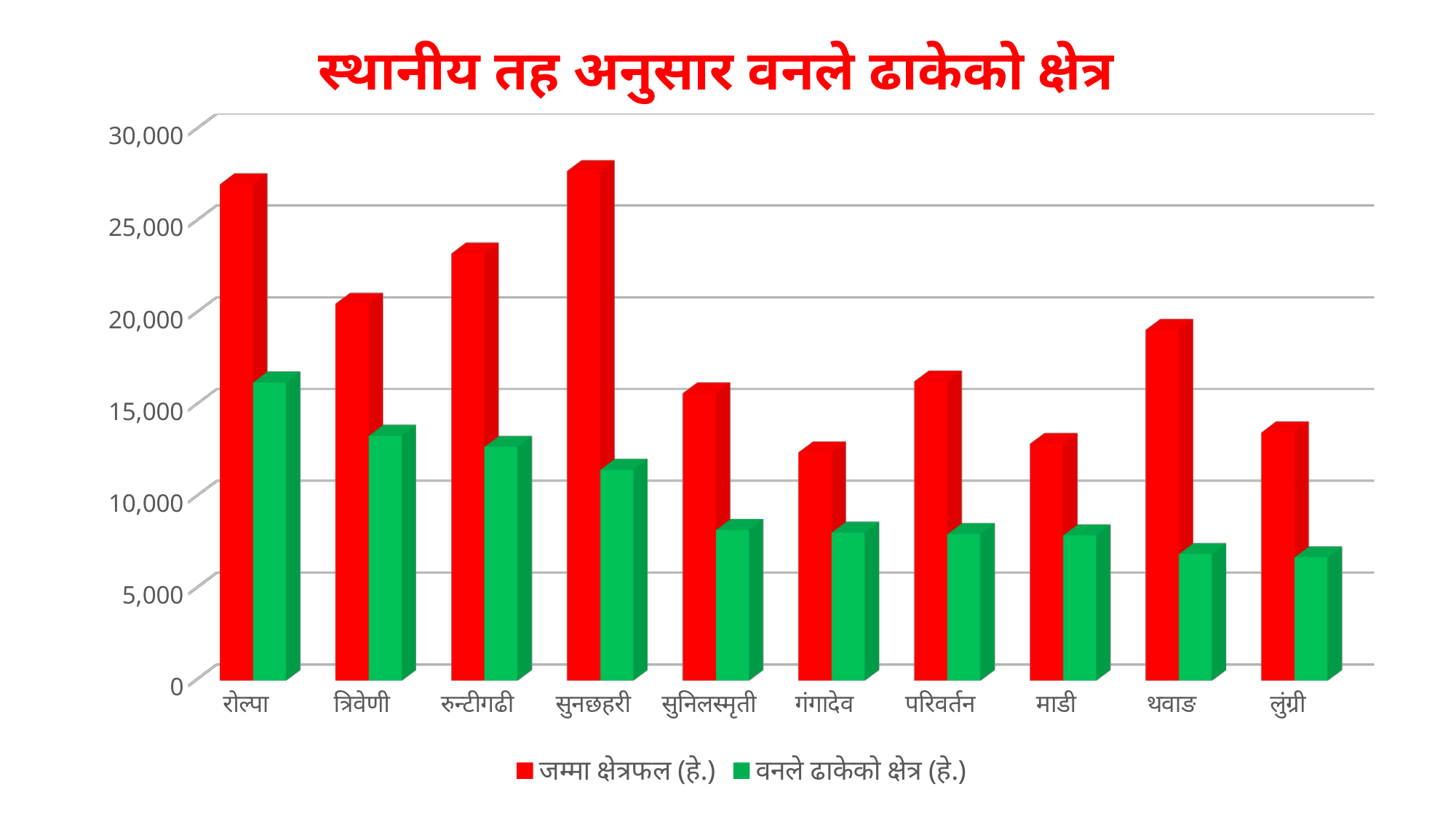
How many series does the legend list? 2 Which colour represents the series जम्मा क्षेत्रफल (हे.)? red Which local level has the highest वनले ढाकेको क्षेत्र (हे.)? रोल्पा How many local levels (categories) are shown on the x axis? 10 What kind of chart is shown on the slide? bar chart What is the title of the chart? स्थानीय तह अनुसार वनले ढाकेको क्षेत्र Is the जम्मा क्षेत्रफल (हे.) value for थवाङ greater or less than 20,000? less Which has the larger जम्मा क्षेत्रफल (हे.), रुन्टीगढी or त्रिवेणी? रुन्टीगढी Which local level has the highest जम्मा क्षेत्रफल (हे.)? सुनछहरी Which has the larger जम्मा क्षेत्रफल (हे.), थवाङ or परिवर्तन? थवाङ Is the जम्मा क्षेत्रफल (हे.) value for रोल्पा greater or less than 25,000? greater Is the वनले ढाकेको क्षेत्र (हे.) value for सुनिलस्मृती greater or less than 10,000? less